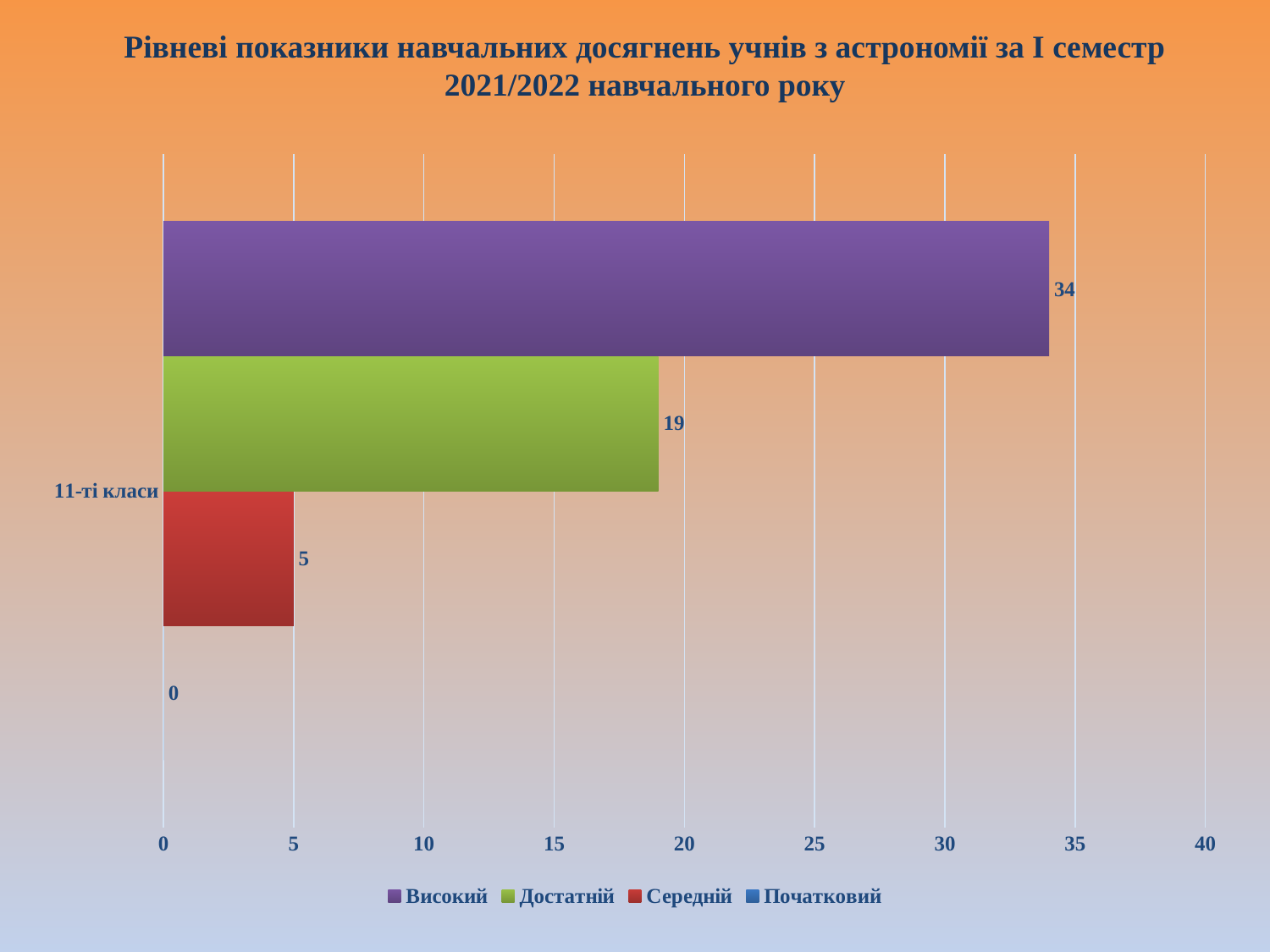
What is the value for the Достатній series for 11-ті класи? 19 Which series has the lowest value for 11-ті класи? Початковий Which is larger for 11-ті класи, Достатній or Середній? Достатній What kind of chart is shown on the slide? bar chart How many series does the legend list? 4 What is the value for the Середній series for 11-ті класи? 5 What is the value for the Високий series for 11-ті класи? 34 What is the difference between the Високий and Достатній values for 11-ті класи? 15 Is the value for Високий greater or less than 30? greater Which series has the highest value for 11-ті класи? Високий What colour is the bar for the Достатній series? green What is the value for the Початковий series for 11-ті класи? 0